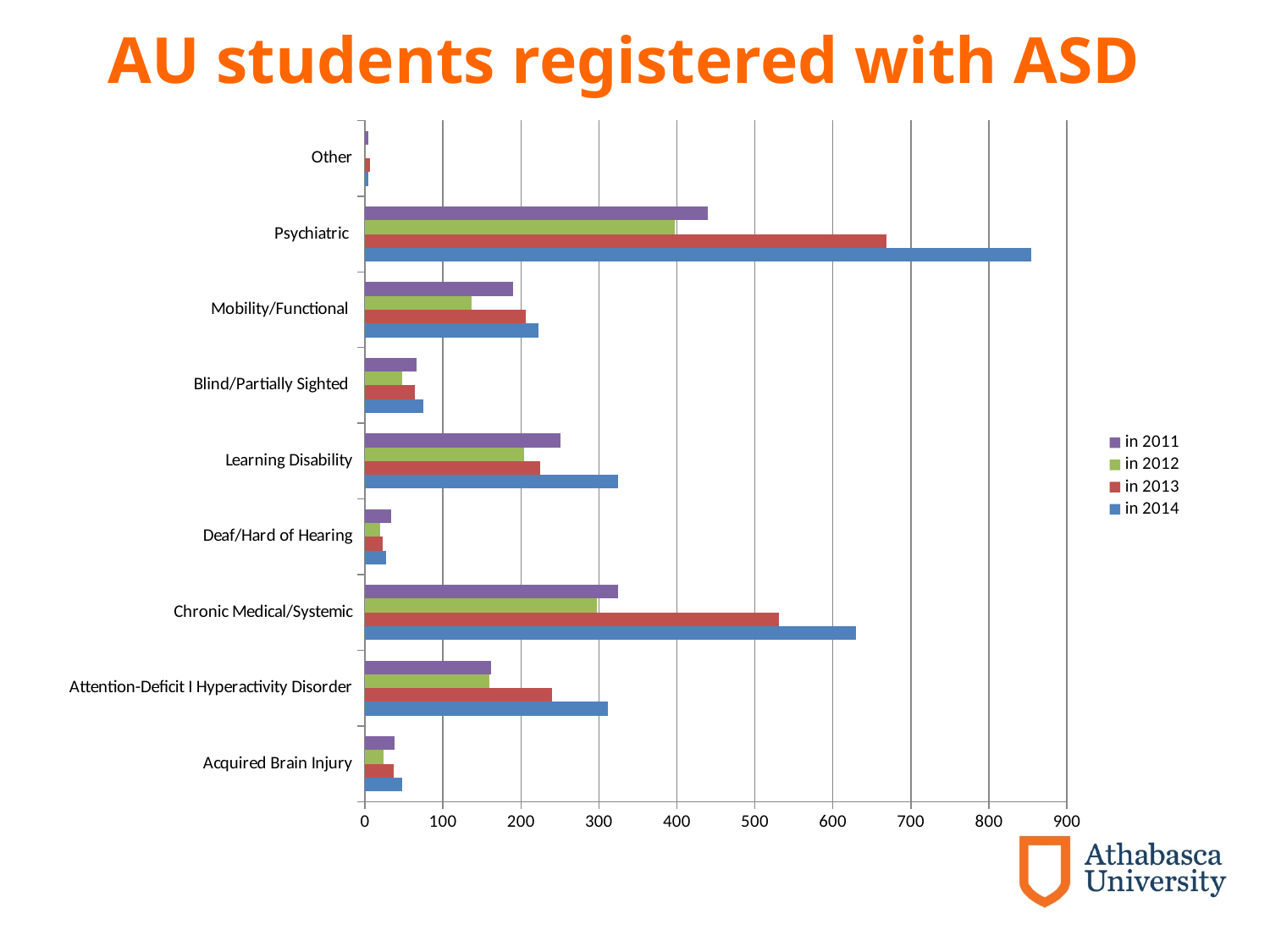
Is the value for Acquired Brain Injury in 2014 greater or less than 100? less Which is larger for in 2014: Psychiatric or Chronic Medical/Systemic? Psychiatric Is the value for Psychiatric in 2014 greater or less than 800? greater Which category has the lowest value for in 2014? Other Which category has the highest value for in 2014? Psychiatric How many categories are shown on the chart? 9 What kind of chart is shown on the slide? bar chart Which is larger for in 2013: Learning Disability or Attention-Deficit I Hyperactivity Disorder? Attention-Deficit I Hyperactivity Disorder What is the title of the chart? AU students registered with ASD Is the value for Chronic Medical/Systemic in 2014 greater or less than 600? greater How many series does the legend list? 4